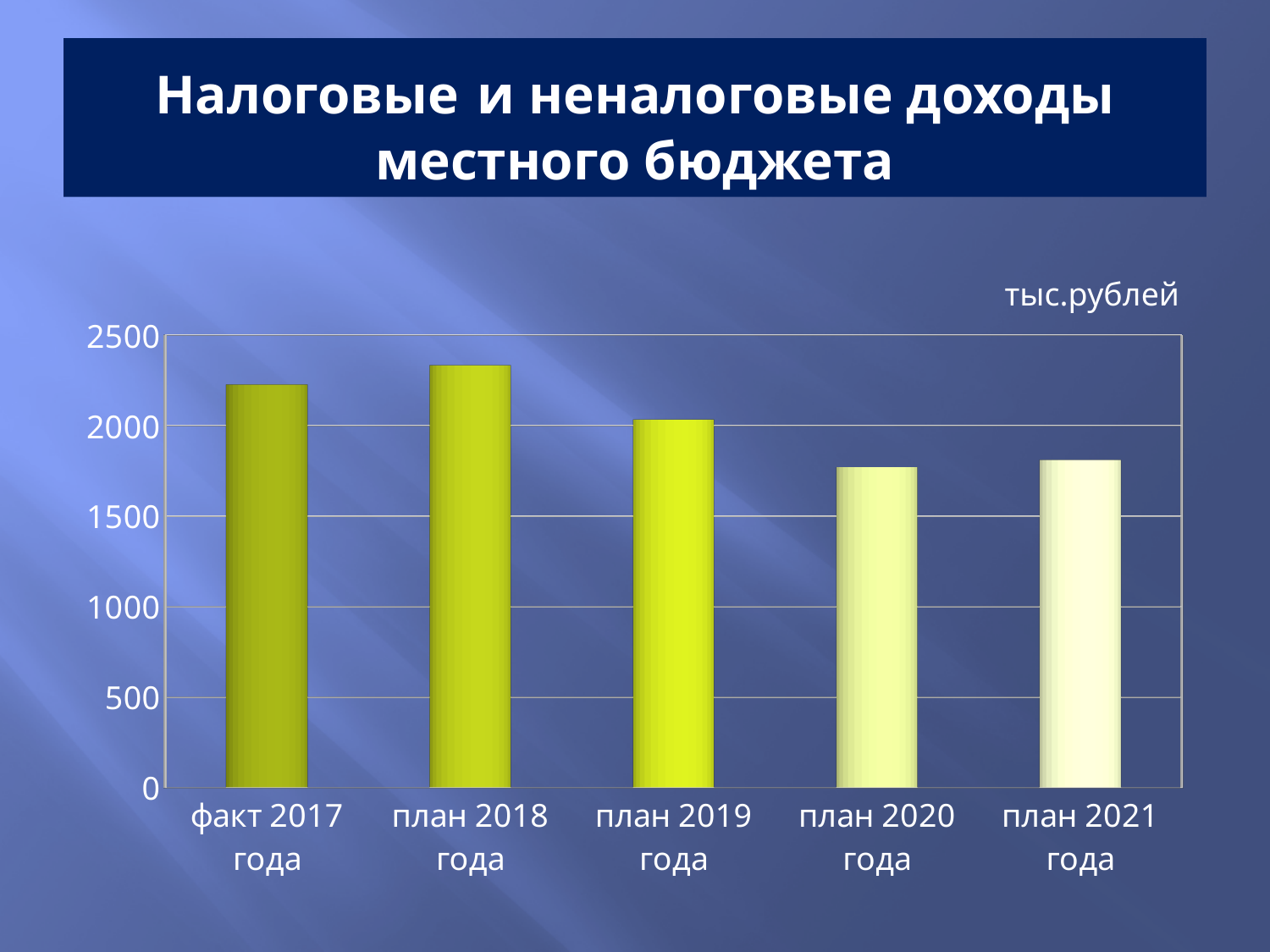
Is the value for план 2020 года greater or less than 2000? less Is the value for план 2018 года greater or less than 2000? greater Do the values rise or fall from план 2018 года to план 2020 года? fall Is the value for план 2020 года greater or less than 1500? greater Which is larger, the value for план 2018 года or the value for план 2019 года? план 2018 года Which category has the highest value on the chart? план 2018 года How many categories (bars) are shown on the chart? 5 What kind of chart is shown on the slide? bar chart Which is larger, the value for факт 2017 года or the value for план 2018 года? план 2018 года What unit of measurement is indicated above the chart? тыс.рублей